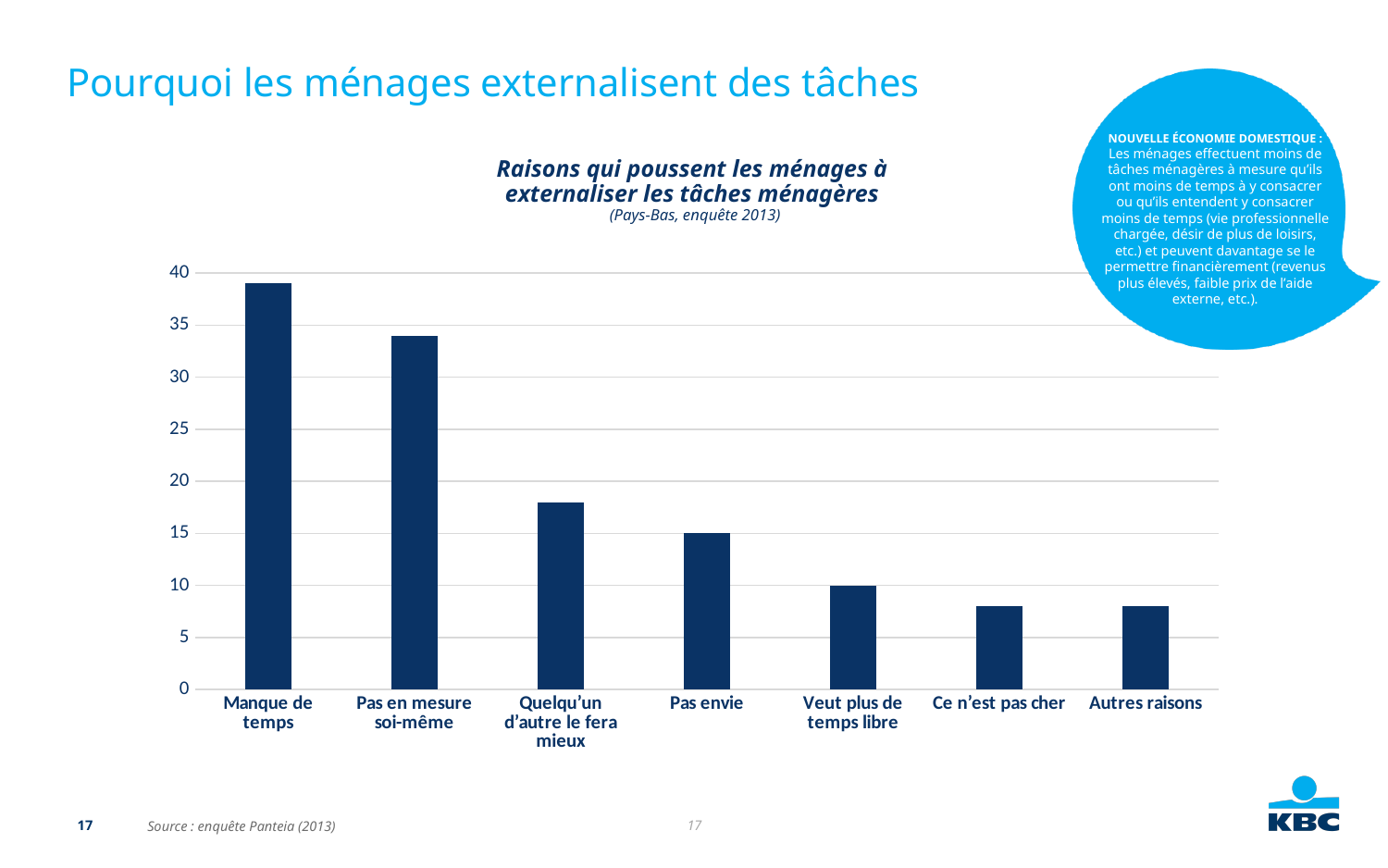
Is the value for 'Pas en mesure soi-même' greater or less than 30? greater Which reason has the highest value in the chart? Manque de temps How many categories (reasons) are shown on the x axis of the chart? 7 Is the value for 'Manque de temps' greater or less than 35? greater Is the value for 'Quelqu'un d'autre le fera mieux' greater or less than 20? less Do the bar values rise or fall from left to right along the x axis? Fall What is the title of the chart? Raisons qui poussent les ménages à externaliser les tâches ménagères Which is larger: the value for 'Pas envie' or the value for 'Veut plus de temps libre'? Pas envie Which is larger: the value for 'Manque de temps' or the value for 'Pas en mesure soi-même'? Manque de temps What kind of chart is shown on the slide? Bar chart